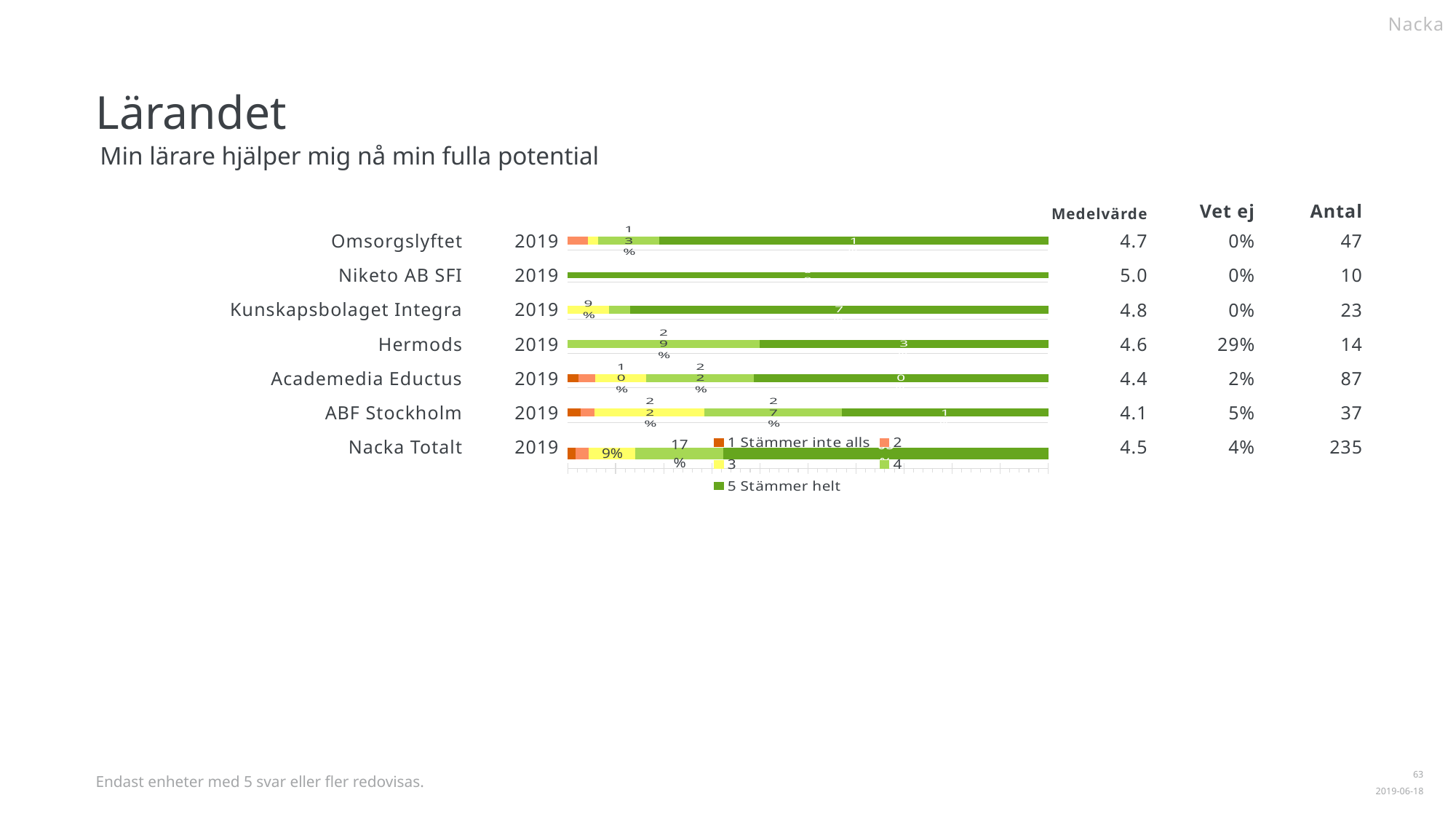
Which unit has the smallest '5 Stämmer helt' segment? ABF Stockholm What is the labelled share of the '4' segment for Academedia Eductus? 22% How many series does the chart legend list? 5 What is the first entry in the chart legend? 1 Stämmer inte alls How much larger is the '3' segment for ABF Stockholm than for Nacka Totalt? 13% What is the labelled share of the '4' segment for Hermods? 29% How many units (categories) are plotted in the chart? 7 What kind of chart is shown on the slide? Stacked bar chart Which unit has the largest '5 Stämmer helt' segment? Niketo AB SFI What is the labelled share of the '4' segment for Nacka Totalt? 17% What is the labelled share of the '3' segment for ABF Stockholm? 22% Which has the larger '3' segment, ABF Stockholm or Omsorgslyftet? ABF Stockholm